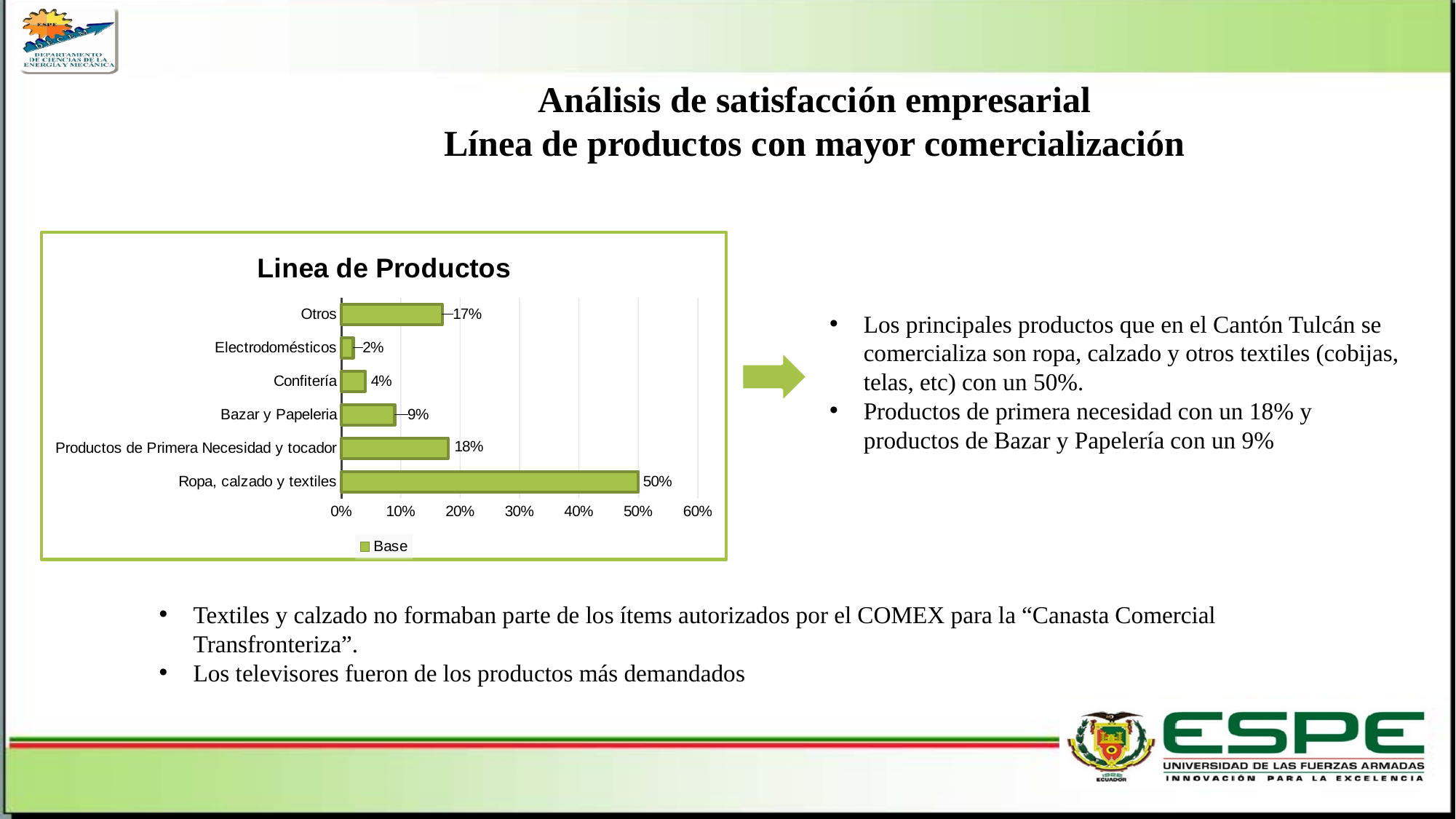
What is the value for Electrodomésticos? 2% Which category has the highest value? Ropa, calzado y textiles What is the title of the chart? Linea de Productos What is the value for Ropa, calzado y textiles? 50% Is the value for Ropa, calzado y textiles greater or less than 40%? greater What is the value for Otros? 17% What is the value for Productos de Primera Necesidad y tocador? 18% How many categories are shown in the chart? 6 Which is larger, the value for Bazar y Papeleria or the value for Confitería? Bazar y Papeleria What kind of chart is shown on the slide? bar chart What is the difference between the values for Ropa, calzado y textiles and Productos de Primera Necesidad y tocador? 32% Which category has the lowest value? Electrodomésticos